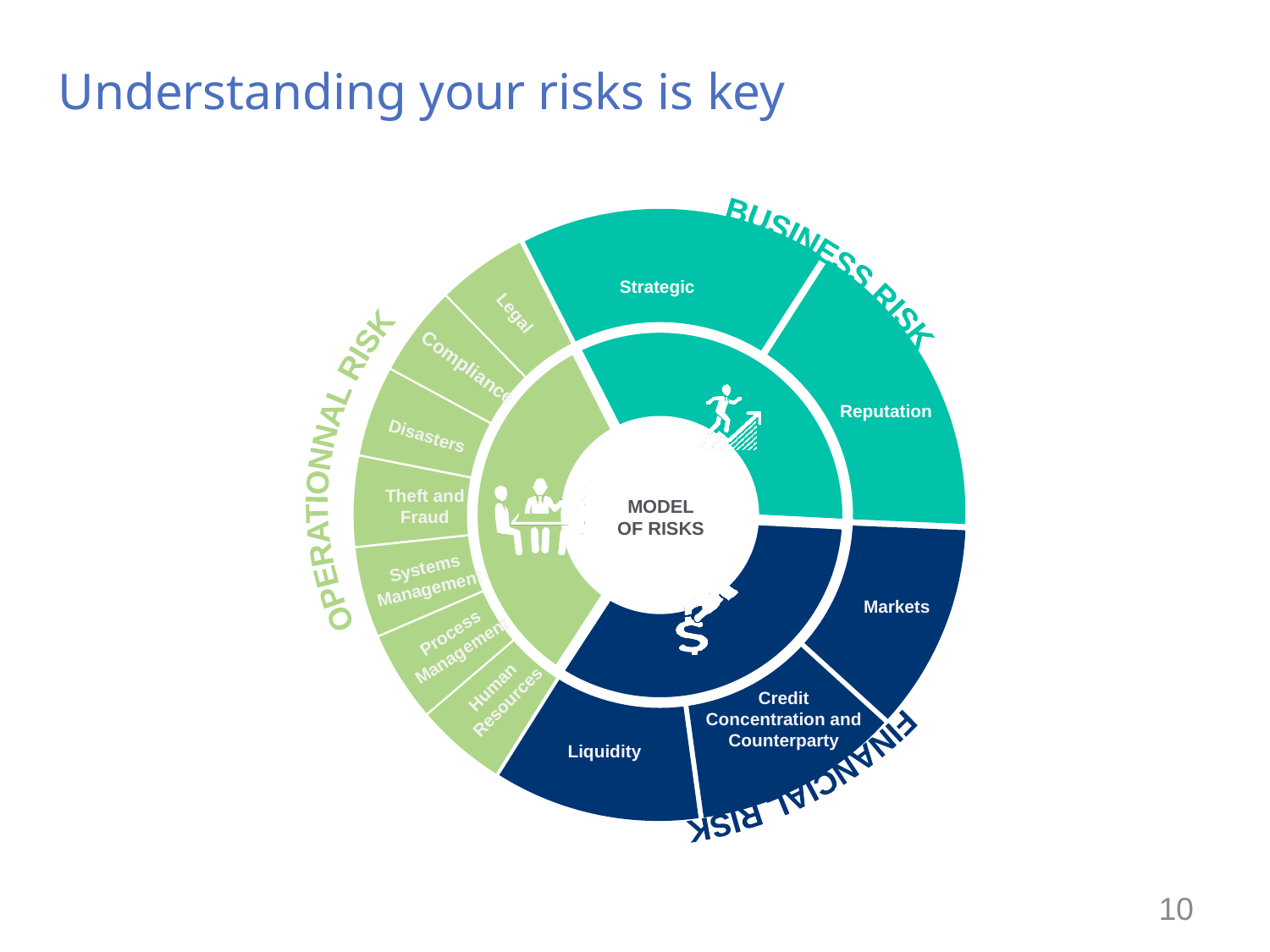
Which main risk category do the Strategic and Reputation segments belong to? Business Risk How many sub-categories are listed under Financial Risk in the outer ring? 3 How many segments are there in total in the outer ring of the diagram? 12 What is the title of the slide? Understanding your risks is key Which main risk category does the Liquidity segment belong to? Financial Risk What colour is used for the Financial Risk section of the diagram? Dark blue How many sub-categories are listed under Operational Risk in the outer ring? 7 Which main risk category does the Compliance segment belong to? Operational Risk